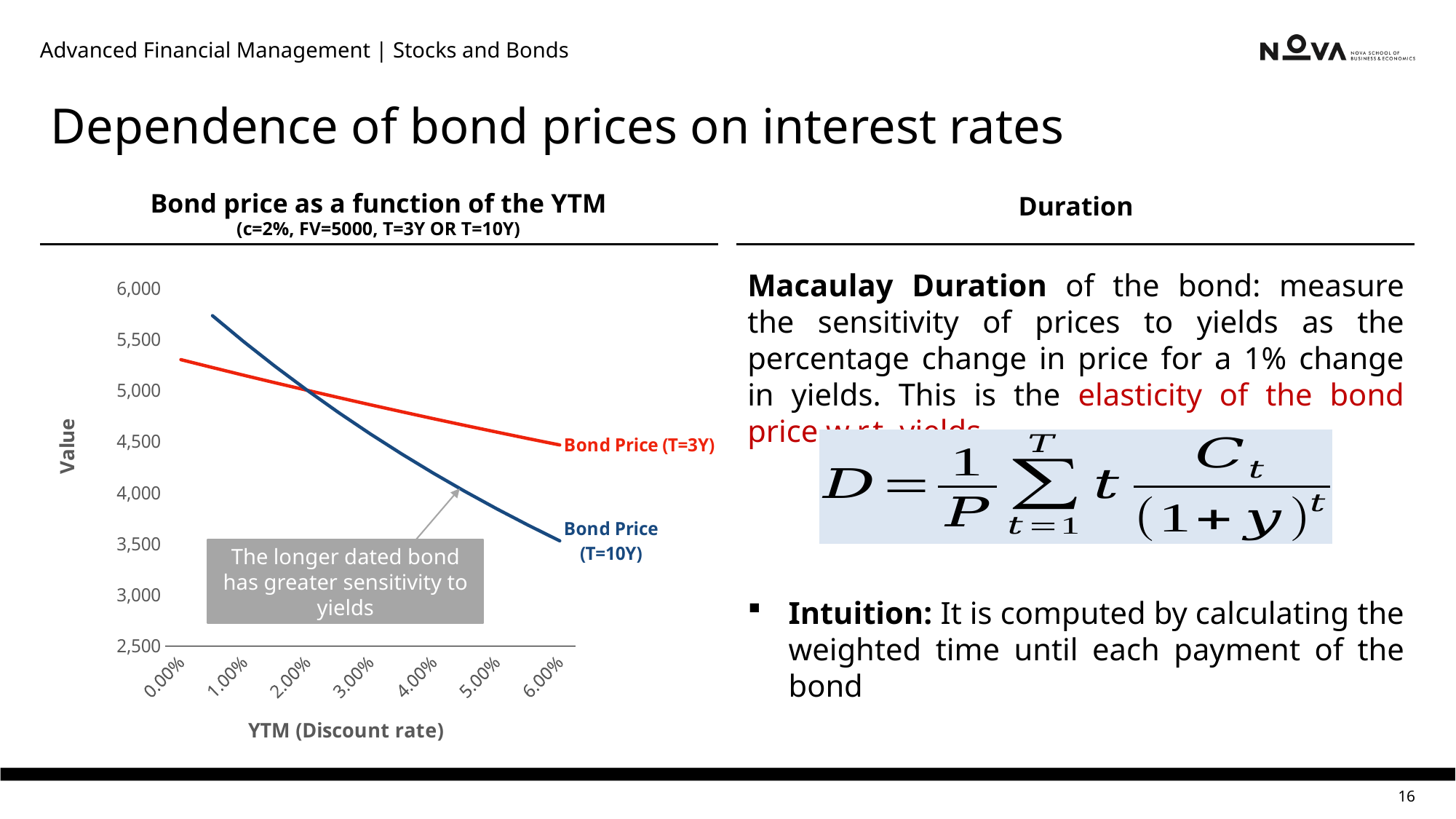
Is the value of Bond Price (T=10Y) at a YTM of 5.00% greater or less than 4,000? less What kind of chart is shown on the slide? line chart Is the value of Bond Price (T=3Y) at a YTM of 0.00% greater or less than 5,500? less Do the values of the Bond Price (T=3Y) series rise or fall as the YTM increases? fall How many series are plotted in the chart? 2 At a YTM of 6.00%, which series has the higher value, Bond Price (T=3Y) or Bond Price (T=10Y)? Bond Price (T=3Y) How many YTM tick labels are shown on the x axis of the chart? 7 What is the label of the x axis of the chart? YTM (Discount rate) Do the values of the Bond Price (T=10Y) series rise or fall as the YTM increases? fall What is the title of the chart? Bond price as a function of the YTM